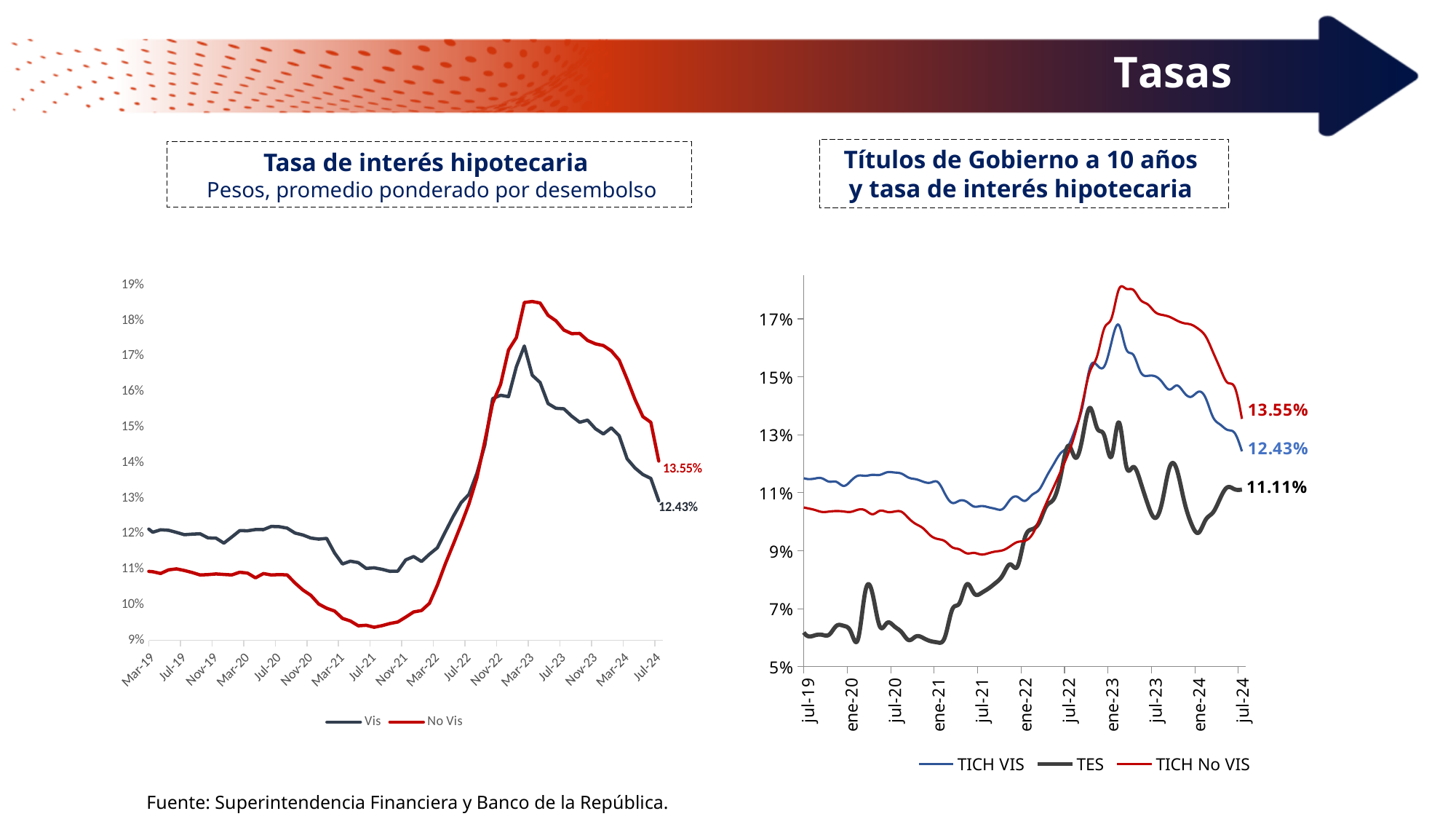
In the 'Títulos de Gobierno a 10 años y tasa de interés hipotecaria' chart, how many series does the legend list? 3 In the 'Tasa de interés hipotecaria' chart, what is the final value shown for the Vis series? 12.43% What kind of chart is the 'Tasa de interés hipotecaria' chart? Line chart In the 'Tasa de interés hipotecaria' chart, what is the final value shown for the No Vis series? 13.55% In the 'Tasa de interés hipotecaria' chart, what is the difference between the final No Vis and Vis values? 1.12% In the 'Títulos de Gobierno a 10 años y tasa de interés hipotecaria' chart, which series has the highest final value? TICH No VIS In the 'Títulos de Gobierno a 10 años y tasa de interés hipotecaria' chart, what is the difference between the final TICH VIS and TES values? 1.32% In the 'Títulos de Gobierno a 10 años y tasa de interés hipotecaria' chart, what is the final value shown for the TES series? 11.11% In the 'Tasa de interés hipotecaria' chart, how many series does the legend list? 2 In the 'Títulos de Gobierno a 10 años y tasa de interés hipotecaria' chart, which series has the lowest final value? TES In the 'Tasa de interés hipotecaria' chart, is the No Vis value at Jul-21 greater or less than 10%? less